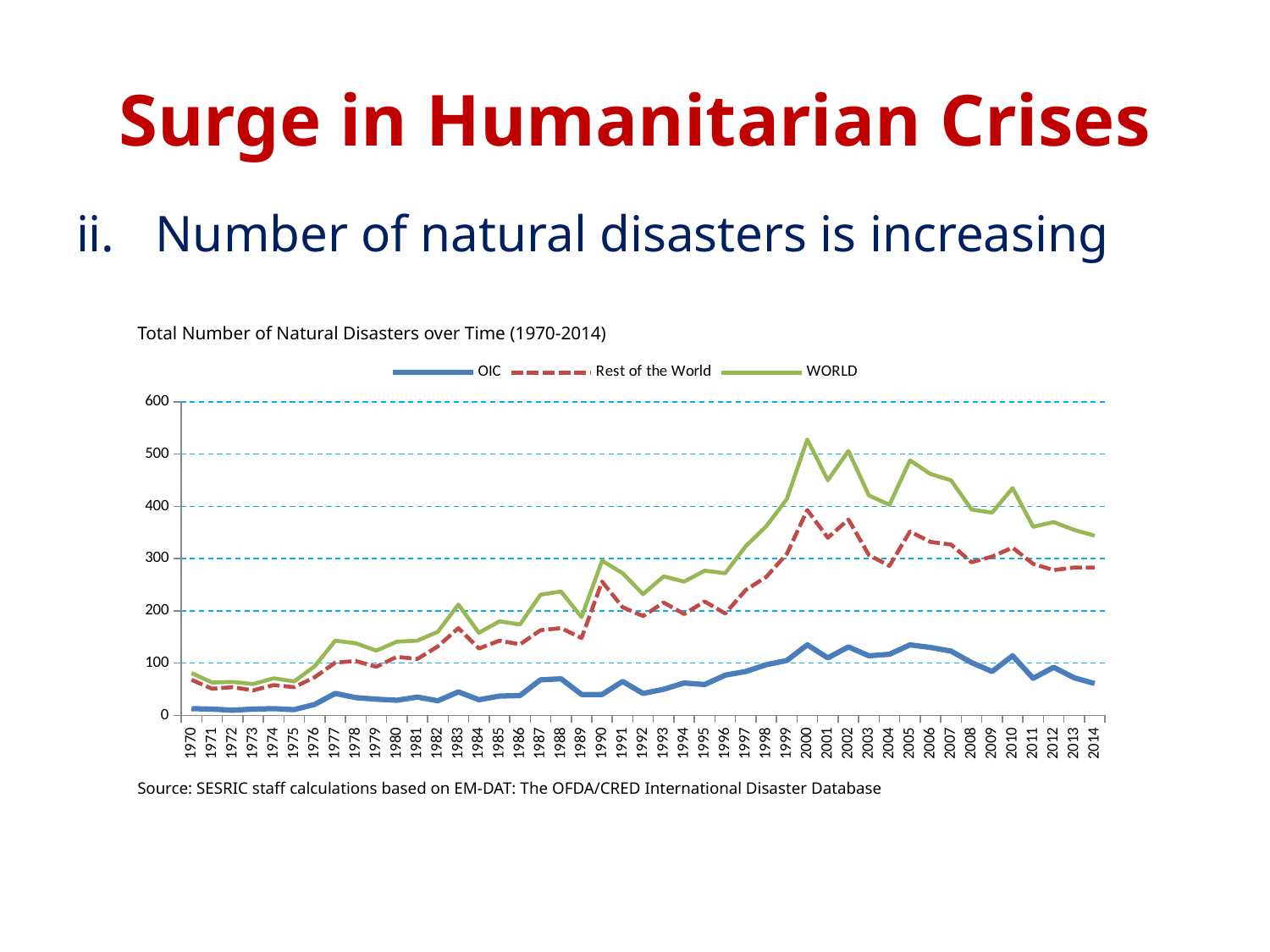
How many series does the legend list? 3 Is the value for WORLD in 2000 greater or less than 500? greater What is the title of the chart? Total Number of Natural Disasters over Time (1970-2014) Is the value for OIC in 1970 greater or less than 100? less Does the WORLD series generally rise or fall from 1970 to 2000? Rise Which series are listed in the legend? OIC, Rest of the World, WORLD What kind of chart is shown on the slide? Line chart Which series has the larger value in 2005, WORLD or OIC? WORLD How many years are plotted along the x axis? 45 Is the value for WORLD in 2014 greater or less than 400? less In which year does the WORLD series reach its highest value? 2000